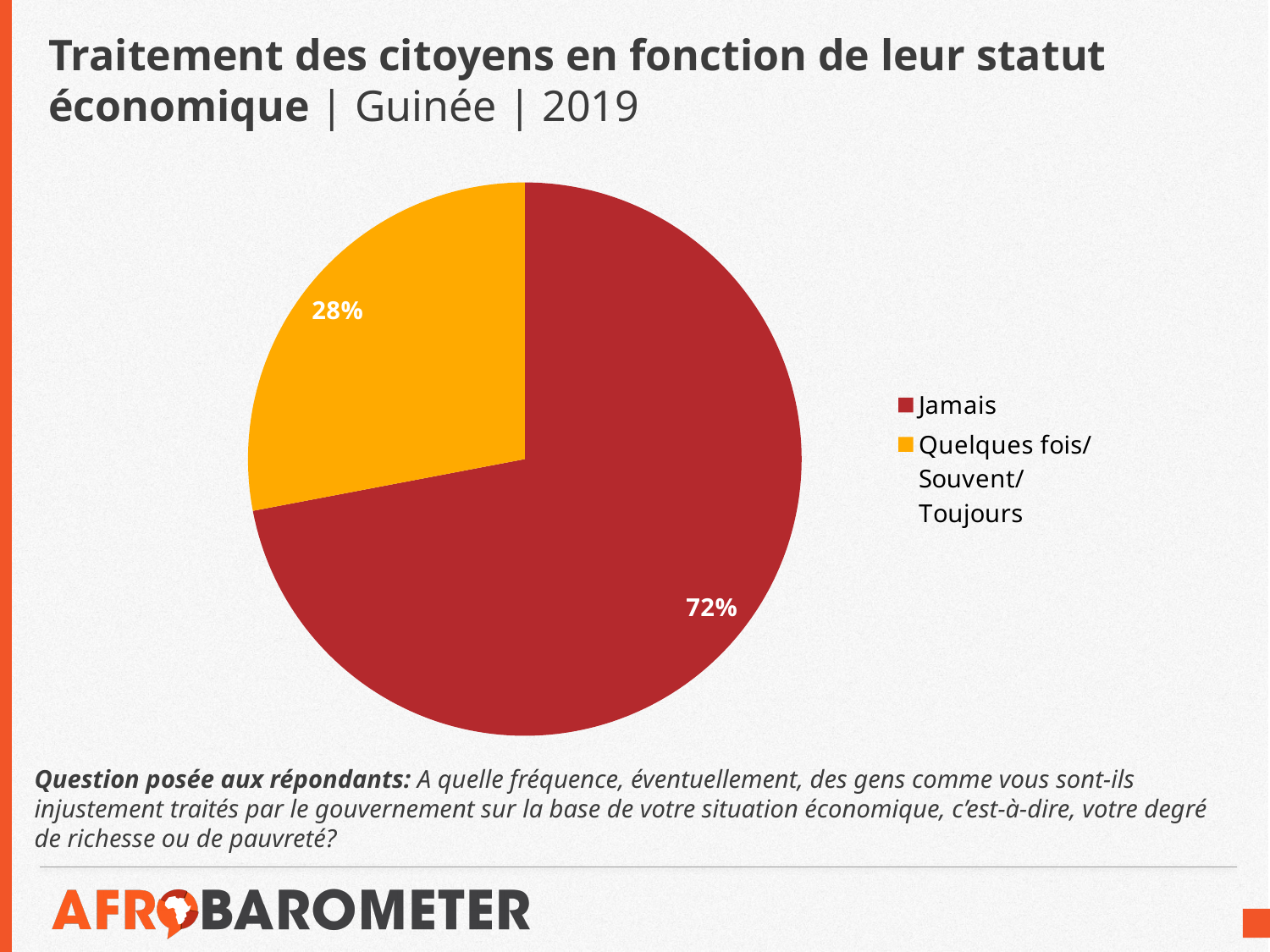
What is the difference in percentage points between "Jamais" and "Quelques fois/ Souvent/ Toujours"? 44 How many entries does the legend list? 2 What percentage of respondents answered "Jamais"? 72% What colour is the "Quelques fois/ Souvent/ Toujours" slice? orange/yellow Which country and year does the chart title refer to? Guinée, 2019 How many slices does the pie chart have? 2 What kind of chart is shown on the slide? pie chart Which category has the largest share of the pie? Jamais Which is larger: the share for "Jamais" or the share for "Quelques fois/ Souvent/ Toujours"? Jamais Which category has the smallest share of the pie? Quelques fois/ Souvent/ Toujours What percentage of respondents answered "Quelques fois/ Souvent/ Toujours"? 28% What share of the pie does the "Jamais" slice represent? 72%